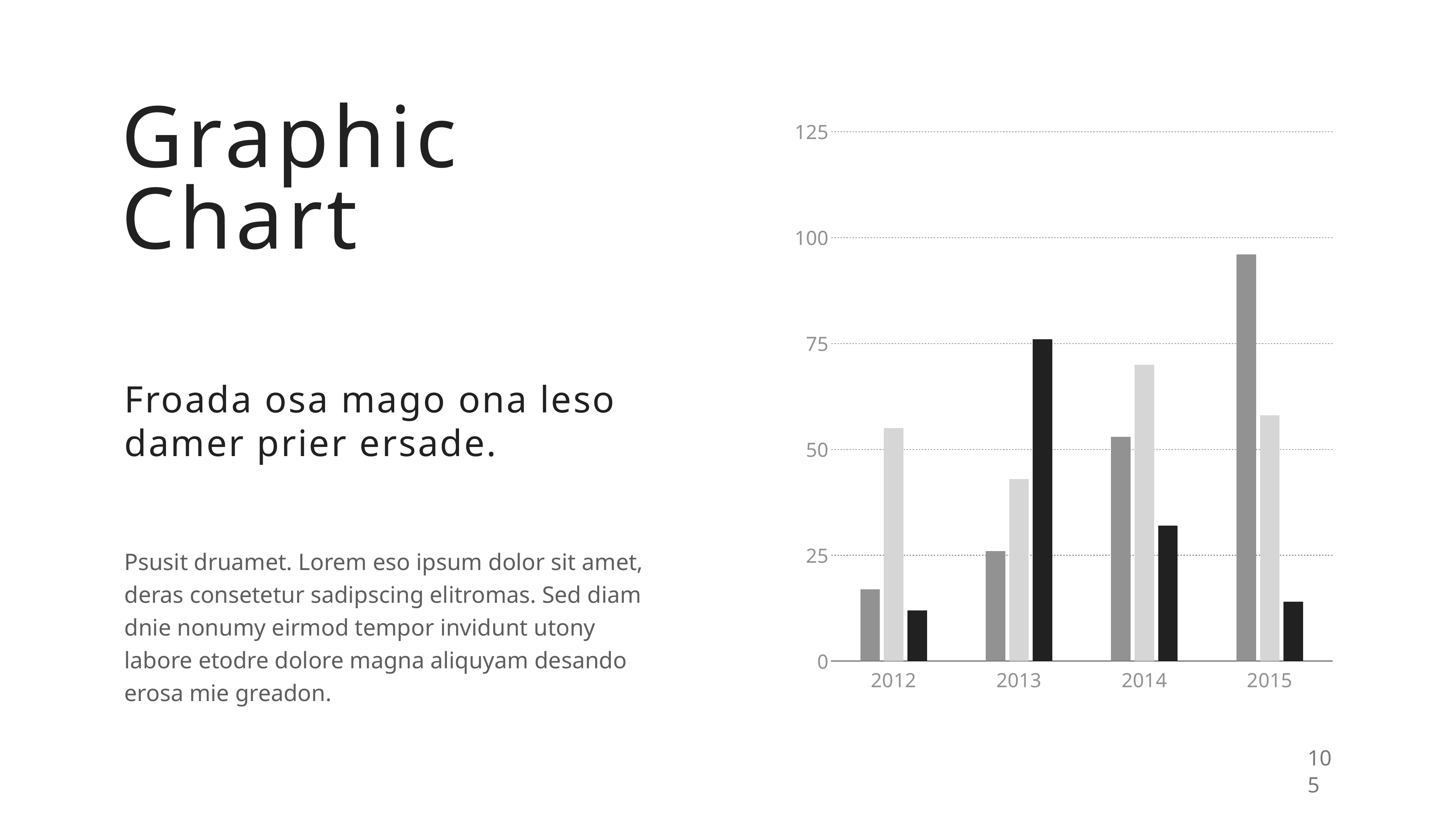
Do the dark grey bars rise or fall from 2012 to 2015? rise In which year is the black bar the tallest? 2013 Is the value of the light grey bar for 2012 greater or less than 50? greater Is the value of the light grey bar for 2014 greater or less than 75? less How many years are shown on the x axis of the chart? 4 What kind of chart is shown on the slide? bar chart Is the value of the black bar for 2014 greater or less than 25? greater In 2014, which is larger: the dark grey bar or the light grey bar? the light grey bar What is the highest value labelled on the y axis of the chart? 125 Which year has the tallest bar in the chart? 2015